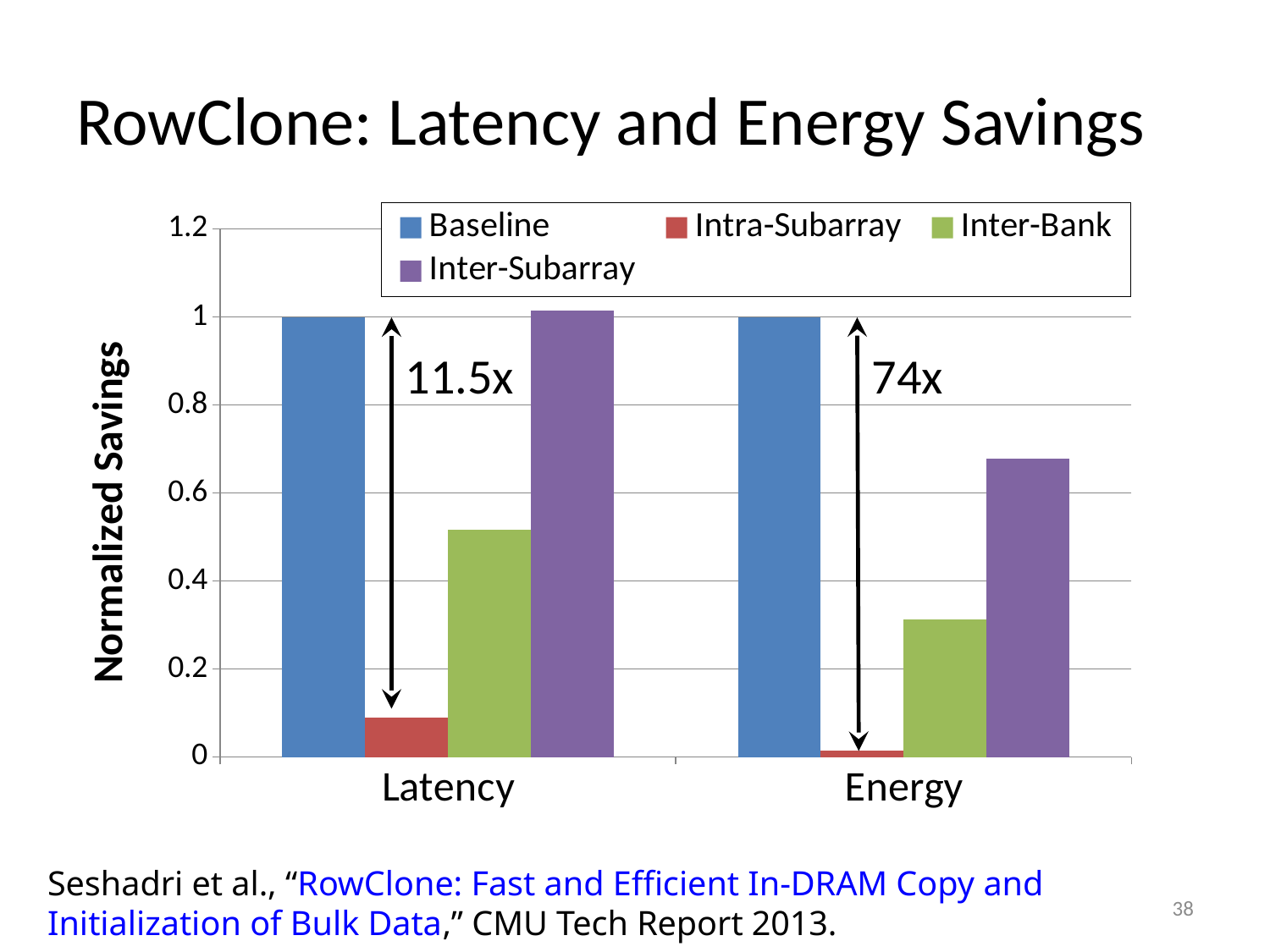
What is the Baseline value for Latency? 1 What improvement factor is annotated between Baseline and Intra-Subarray for Latency? 11.5x What type of chart is shown on the slide? Bar chart Is the Inter-Subarray value for Energy greater or less than 0.6? greater Is the Inter-Bank value for Latency or for Energy larger? Latency Which series has the highest value in the Energy group? Baseline What is the Baseline value for Energy? 1 Is the Inter-Bank value for Latency greater or less than 0.4? greater Which series has the lowest value in the Energy group? Intra-Subarray What improvement factor is annotated between Baseline and Intra-Subarray for Energy? 74x How many categories are shown on the x axis? 2 How many series does the legend list? 4